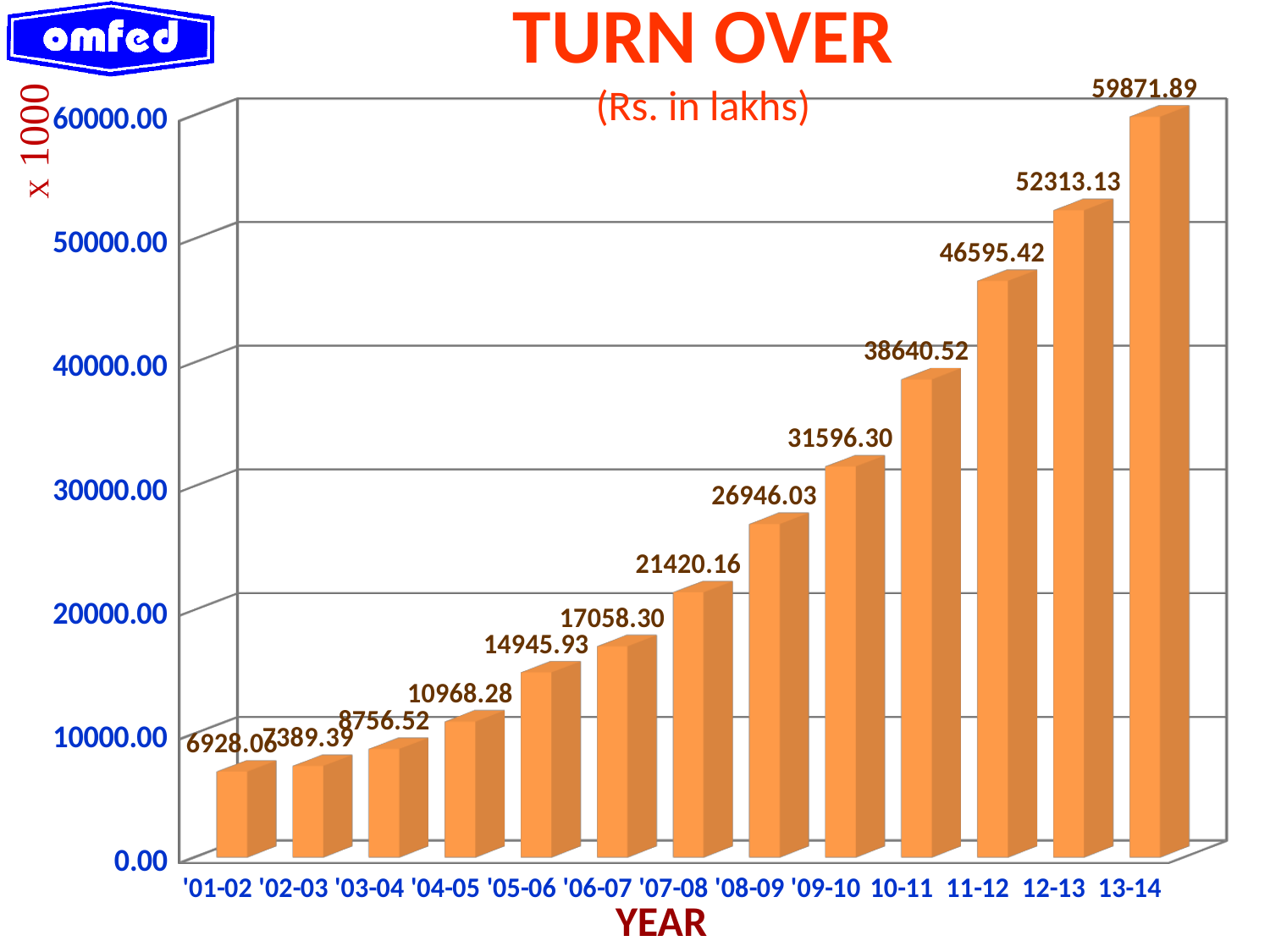
Which year has the highest turnover? 13-14 Is the turnover for 11-12 greater or less than 40000.00? greater What is the difference between the turnover for 13-14 and 12-13? 7558.76 Which year has the lowest turnover? '01-02 What is the difference between the turnover for '07-08 and '06-07? 4361.86 What is the turnover value shown for '04-05? 10968.28 What is the turnover value shown for '07-08? 21420.16 What is the turnover value shown for 10-11? 38640.52 Which year has a larger turnover, '08-09 or '09-10? '09-10 What kind of chart is shown on the slide? Bar chart What is the turnover value shown for 13-14? 59871.89 How many years are shown on the x axis? 13